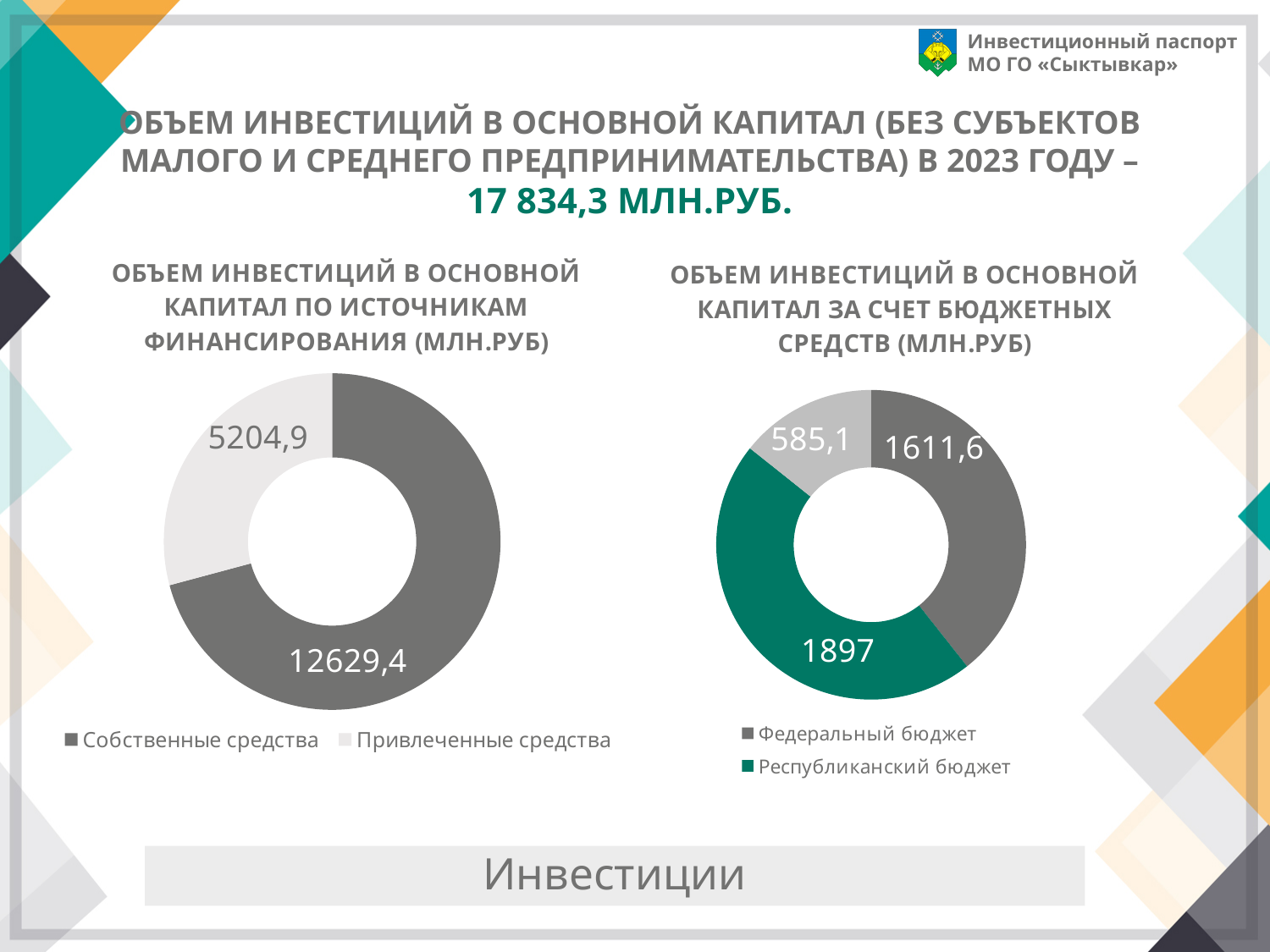
In the right chart (за счет бюджетных средств), what is the value for Республиканский бюджет? 1897 What type of chart is the left chart (по источникам финансирования)? Donut (pie) chart In the left chart (по источникам финансирования), what is the total of the two slices? 17834,3 In the left chart (по источникам финансирования), which source of financing has the larger value? Собственные средства In the right chart (за счет бюджетных средств), what is the value for Федеральный бюджет? 1611,6 In the left chart (по источникам финансирования), what is the value for Собственные средства? 12629,4 In the right chart (за счет бюджетных средств), how many slices does the donut have? 3 In the right chart (за счет бюджетных средств), what is the difference between Республиканский бюджет and Федеральный бюджет? 285,4 In the right chart (за счет бюджетных средств), what colour is the Республиканский бюджет slice? Green In the left chart (по источникам финансирования), what is the value for Привлеченные средства? 5204,9 In the left chart (по источникам финансирования), what is the difference between Собственные средства and Привлеченные средства? 7424,5 In the right chart (за счет бюджетных средств), which is larger: Федеральный бюджет or Республиканский бюджет? Республиканский бюджет